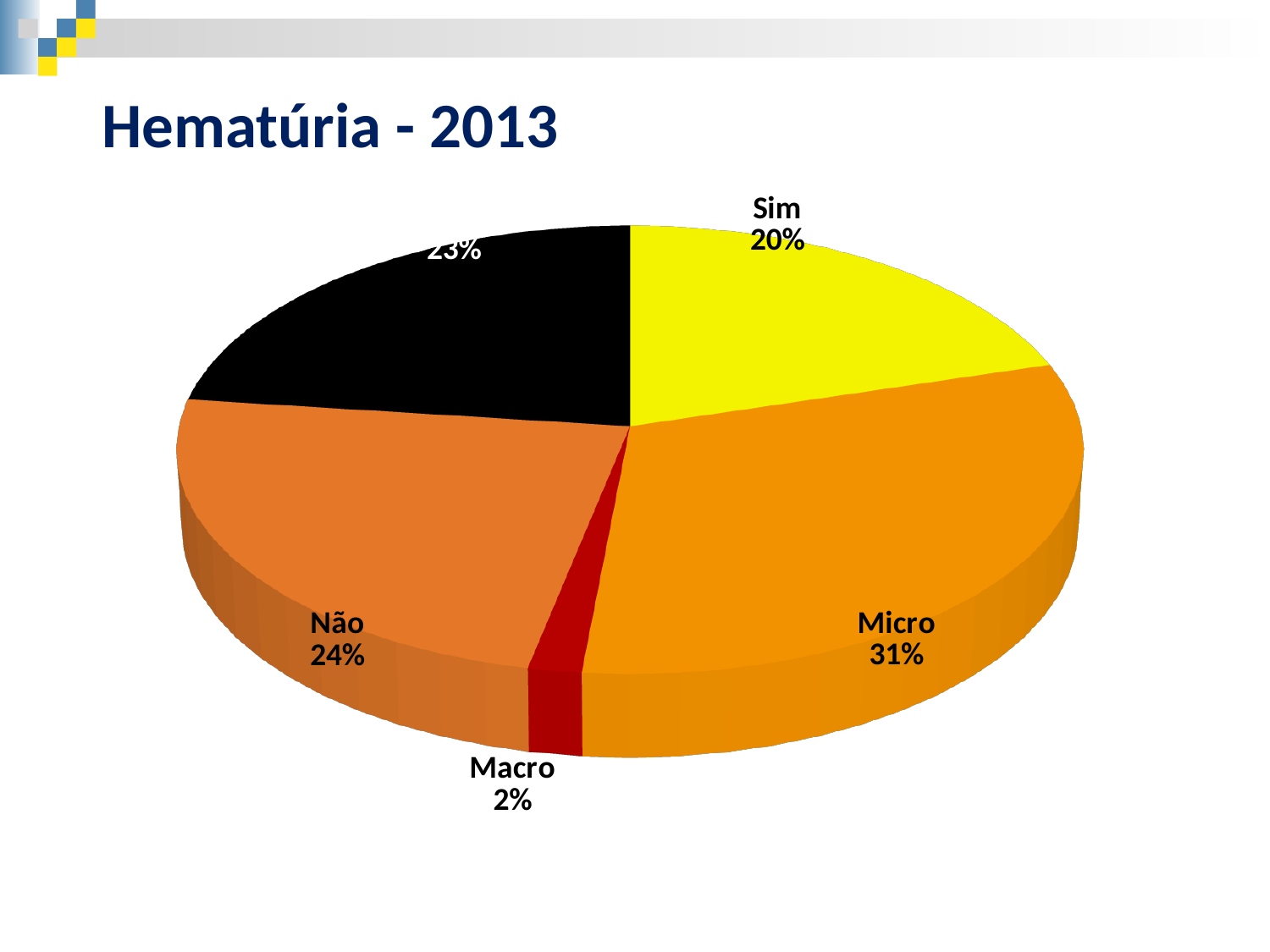
Which slice is larger, Sim or Não? Não Which labelled slice has the largest share of the pie? Micro What colour is the Macro slice? red What percentage does the Macro slice represent? 2% What percentage does the Não slice represent? 24% What percentage does the Sim slice represent? 20% What percentage does the Micro slice represent? 31% What is the title of the chart? Hematúria - 2013 Which slice has the smallest share of the pie? Macro What is the difference in percentage points between the Micro and Não slices? 7 How many slices does the pie chart have? 5 What kind of chart is shown on the slide? pie chart